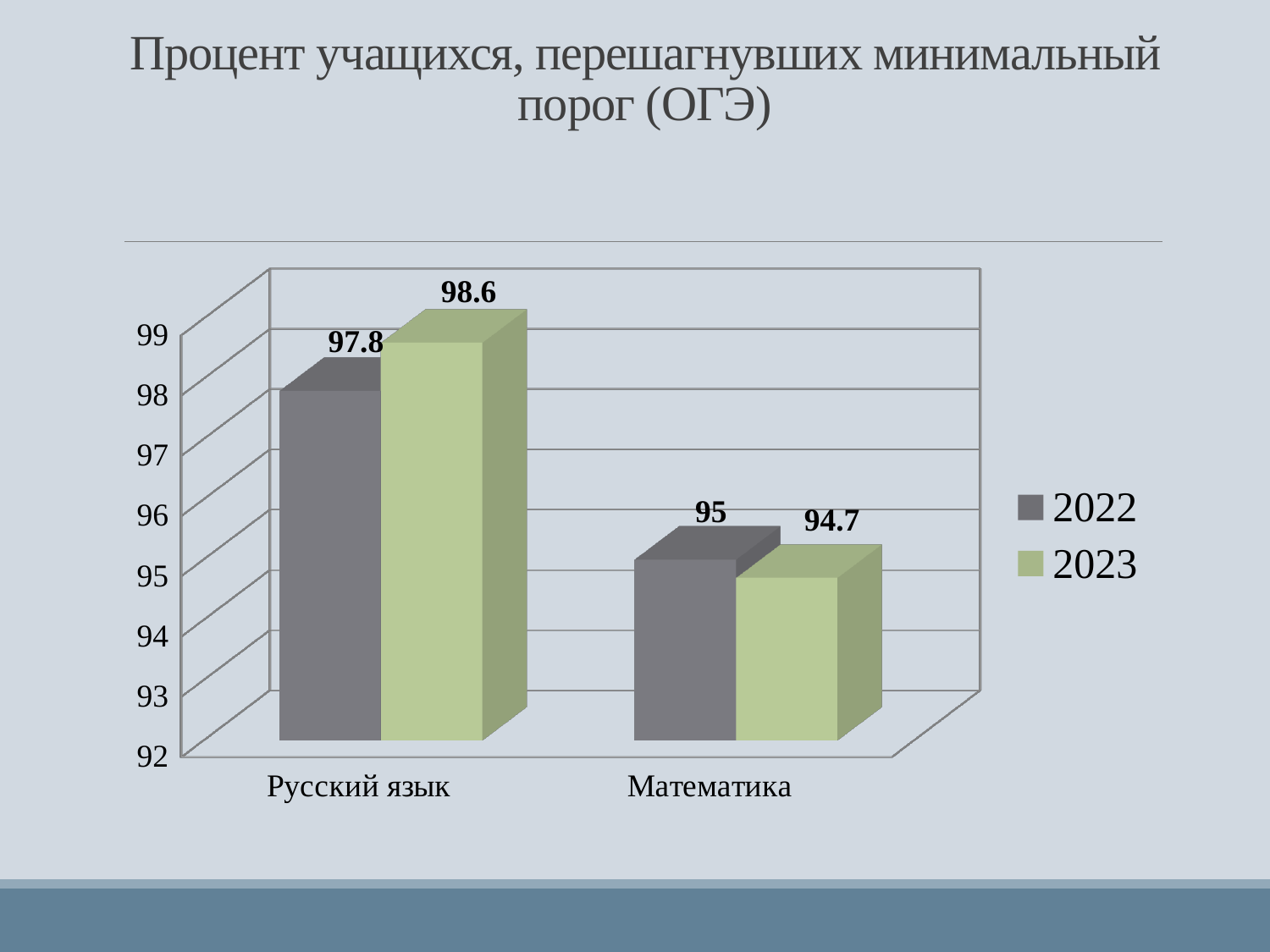
What is the value for Русский язык in 2023? 98.6 Which is larger for Математика: the 2022 value or the 2023 value? 2022 How many categories are shown on the x axis? 2 What is the value for Математика in 2022? 95 What is the difference between the 2023 and 2022 values for Русский язык? 0.8 Which category has the lowest value in the 2022 series? Математика What kind of chart is shown on the slide? Bar chart What is the value for Математика in 2023? 94.7 What is the value for Русский язык in 2022? 97.8 How many series does the legend list? 2 Which category has the highest value in the 2023 series? Русский язык What is the title of the chart on the slide? Процент учащихся, перешагнувших минимальный порог (ОГЭ)